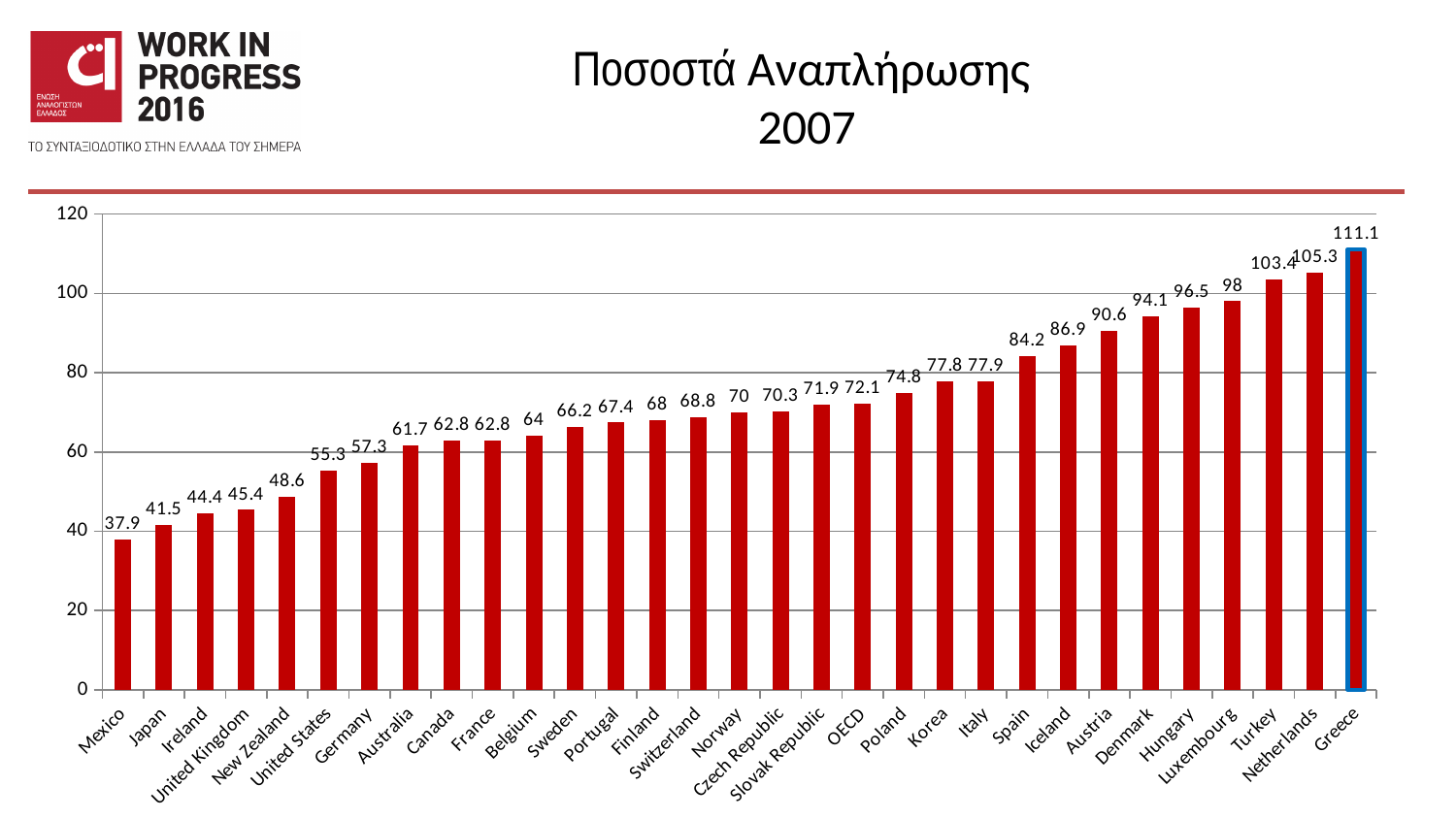
What is the difference between the values for Greece and the Netherlands? 5.8 Is the value for Turkey greater or less than 100? greater Which is larger, the value for Spain or the value for Iceland? Iceland What is the difference between the values for Greece and Mexico? 73.2 What is the value for Greece? 111.1 What is the value for OECD? 72.1 How many categories are shown on the x axis? 31 What is the value for Germany? 57.3 Do the values rise or fall from left to right along the x axis? rise What kind of chart is shown on the slide? bar chart Which country has the highest value? Greece Which country has the lowest value? Mexico